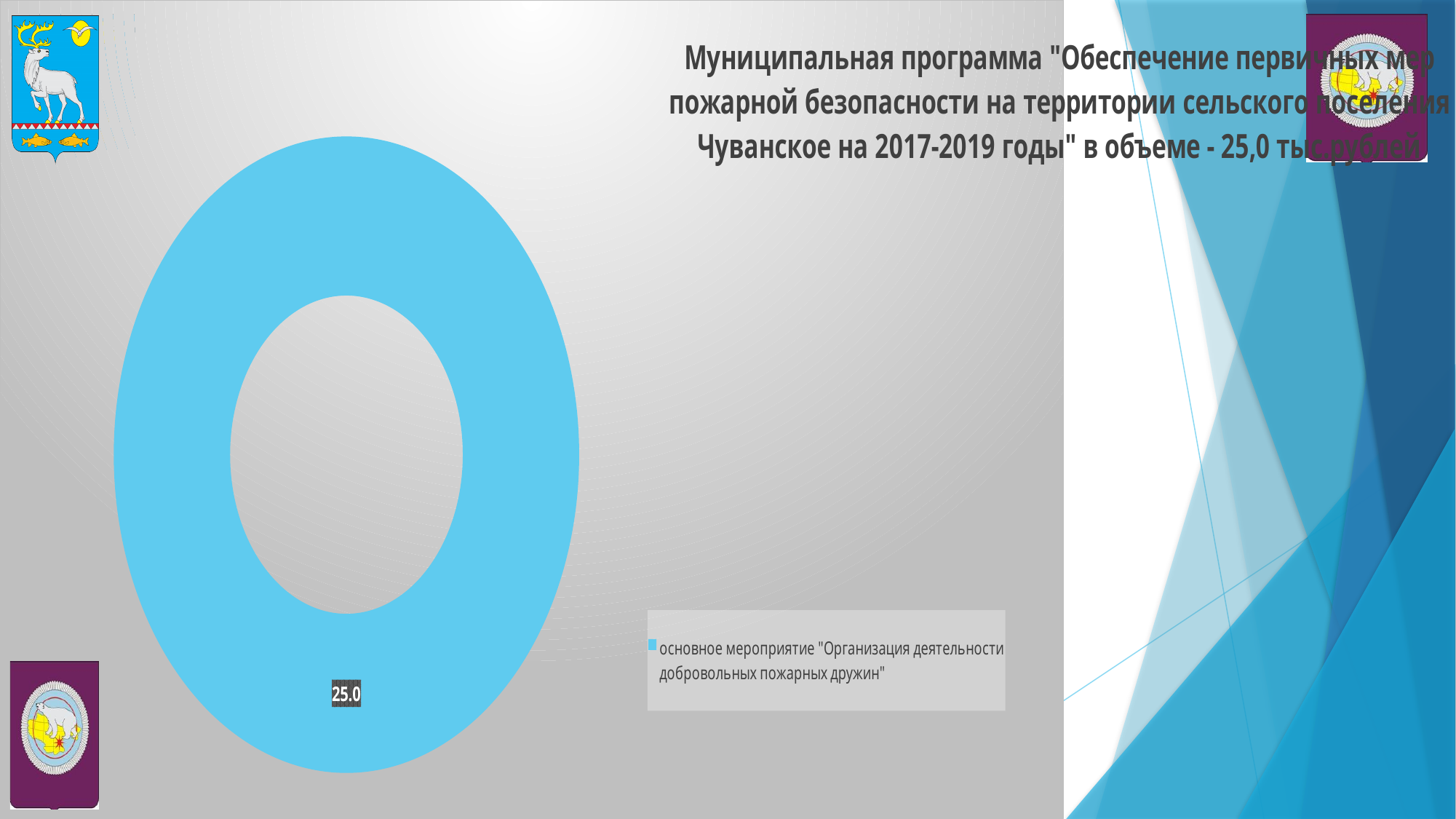
What value is shown on the data label of the doughnut chart? 25.0 What kind of chart is shown on the slide? Doughnut chart What colour is the slice of the doughnut chart? Light blue What share of the doughnut chart does the slice labelled 25.0 represent? 100% How many slices does the doughnut chart contain? 1 How many entries does the chart legend list? 1 What is the name of the only category listed in the chart legend? основное мероприятие "Организация деятельности добровольных пожарных дружин" What is the value for the category "основное мероприятие "Организация деятельности добровольных пожарных дружин""? 25.0